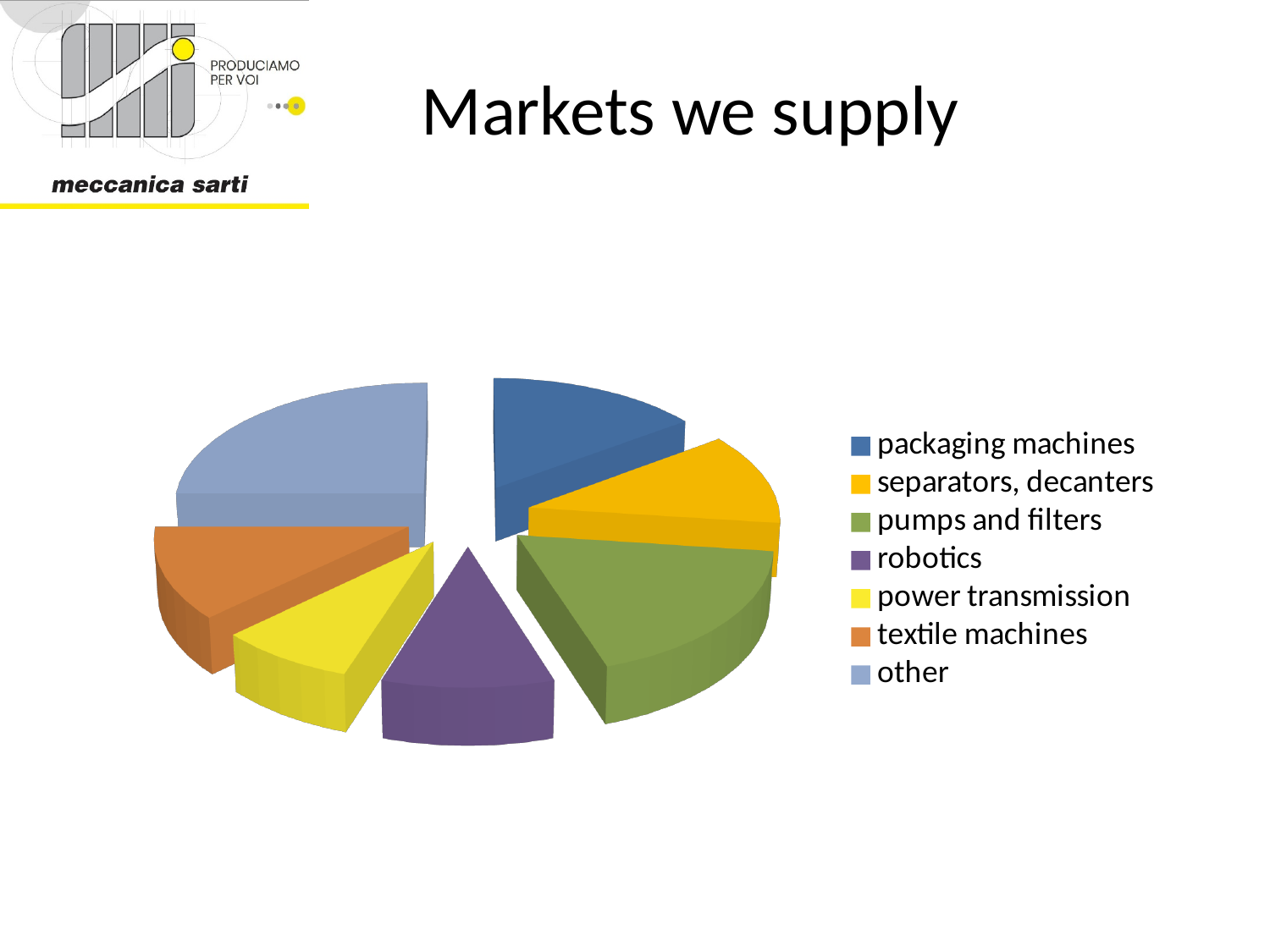
How many slices does the pie chart have? 7 What is the title of the slide containing the pie chart? Markets we supply Which slice is larger, pumps and filters or robotics? pumps and filters What kind of chart is shown on the slide? pie chart Which slice is larger, other or robotics? other Which category has the largest slice of the pie chart? other Which slice is larger, pumps and filters or power transmission? pumps and filters Which category is shown in yellow in the pie chart legend? power transmission